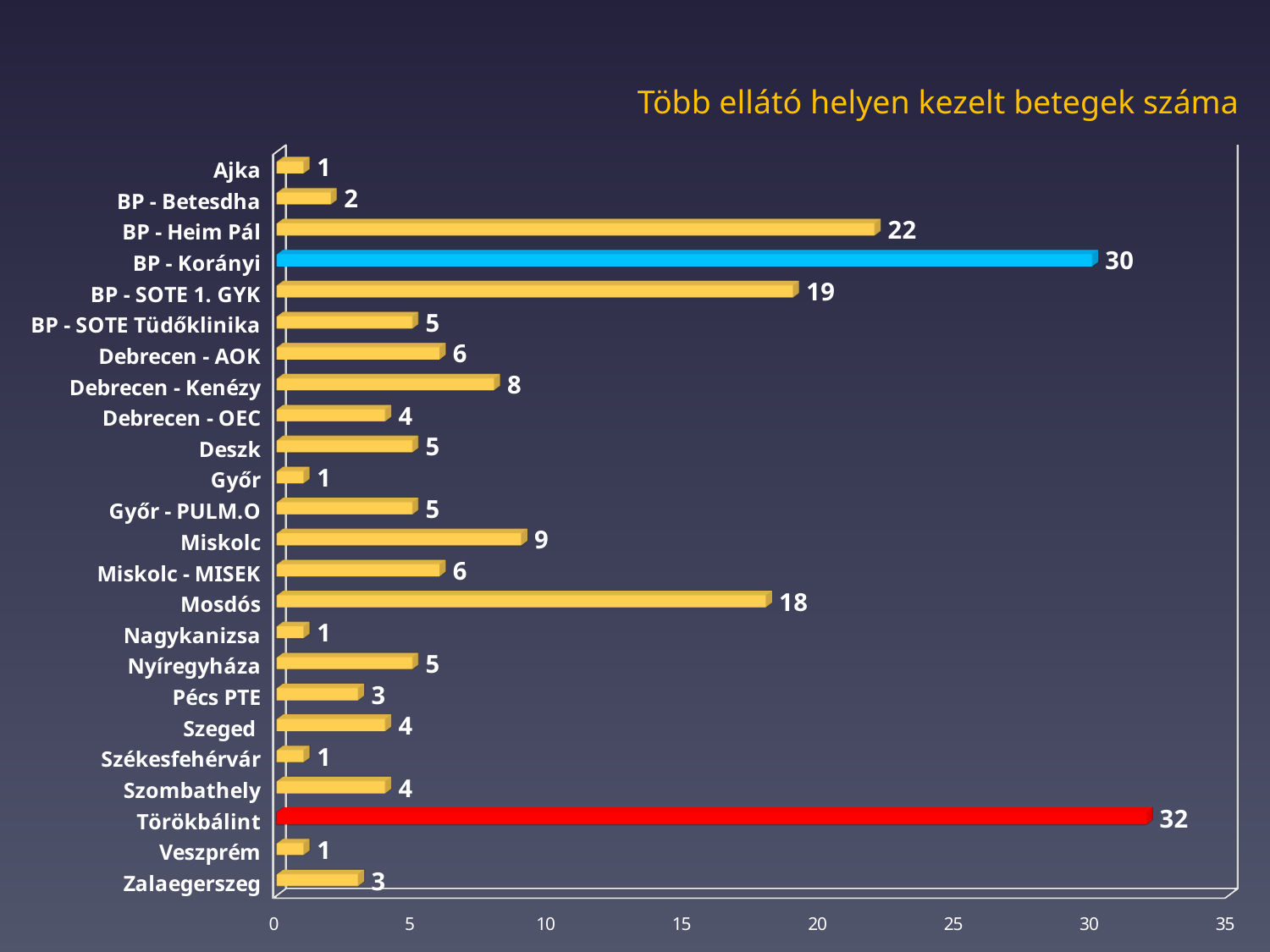
What is the value for BP - Korányi? 30 What is the difference between the values for Törökbálint and BP - Korányi? 2 What is the value for Törökbálint? 32 How many categories are shown on the chart? 24 What is the value for Mosdós? 18 What is the value for BP - SOTE 1. GYK? 19 What kind of chart is shown on the slide? bar chart What is the difference between the values for BP - Heim Pál and Mosdós? 4 Which is larger, the value for Miskolc or the value for Debrecen - Kenézy? Miskolc Which category has the highest value? Törökbálint What colour is the bar for Törökbálint? red What is the title of the chart? Több ellátó helyen kezelt betegek száma